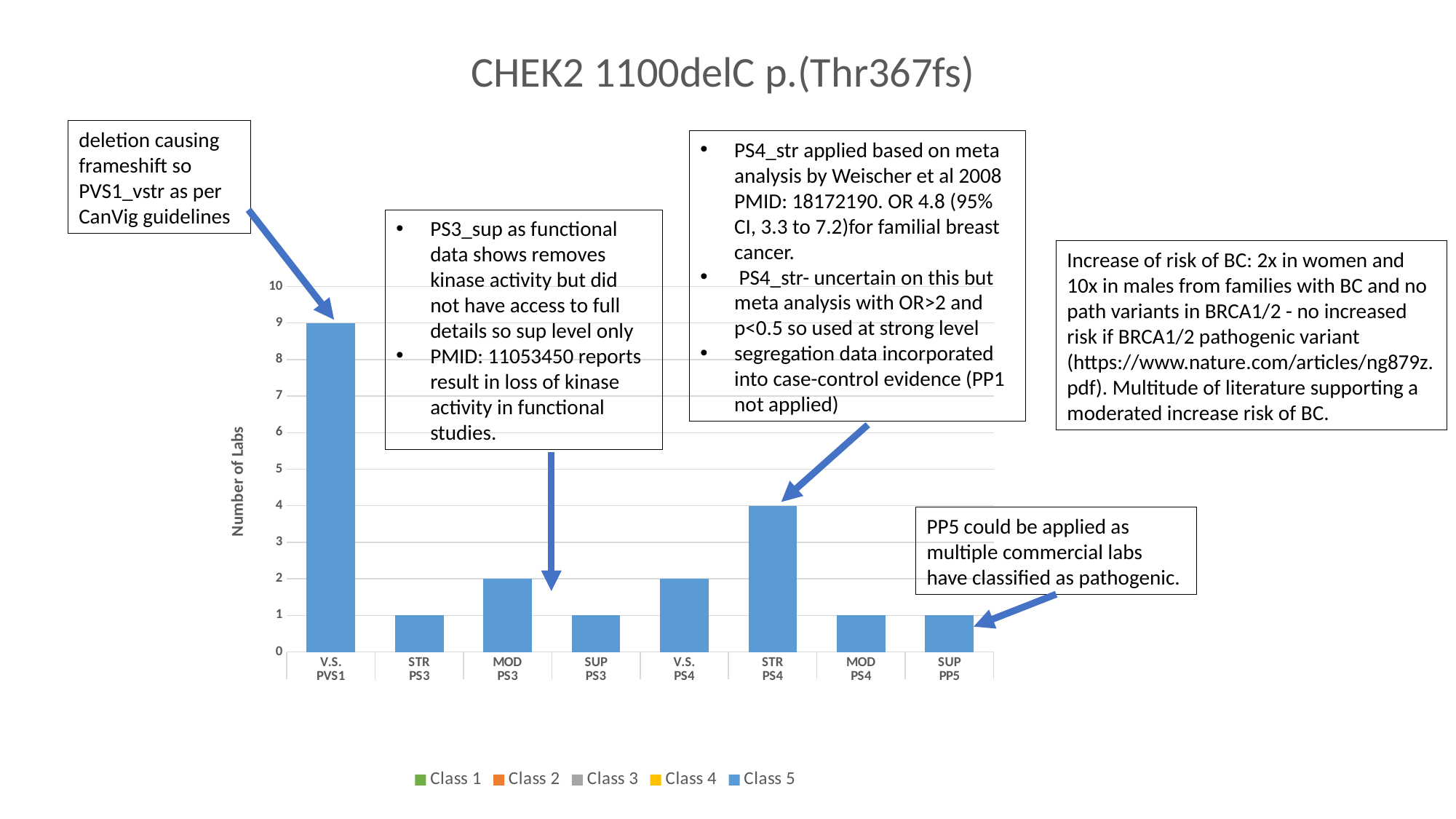
Which category has the highest number of labs? V.S. PVS1 What is the title of the slide? CHEK2 1100delC p.(Thr367fs) How many labs are shown for STR PS4? 4 Which has more labs, STR PS4 or V.S. PS4? STR PS4 How many labs are shown for V.S. PVS1? 9 Is the value for V.S. PVS1 greater or less than 5? greater What type of chart is shown on the slide? bar chart What is the label of the vertical axis? Number of Labs How many series does the legend list? 5 How many labs are shown for MOD PS3? 2 How many categories are shown on the x axis? 8 What is the difference in number of labs between V.S. PVS1 and STR PS4? 5